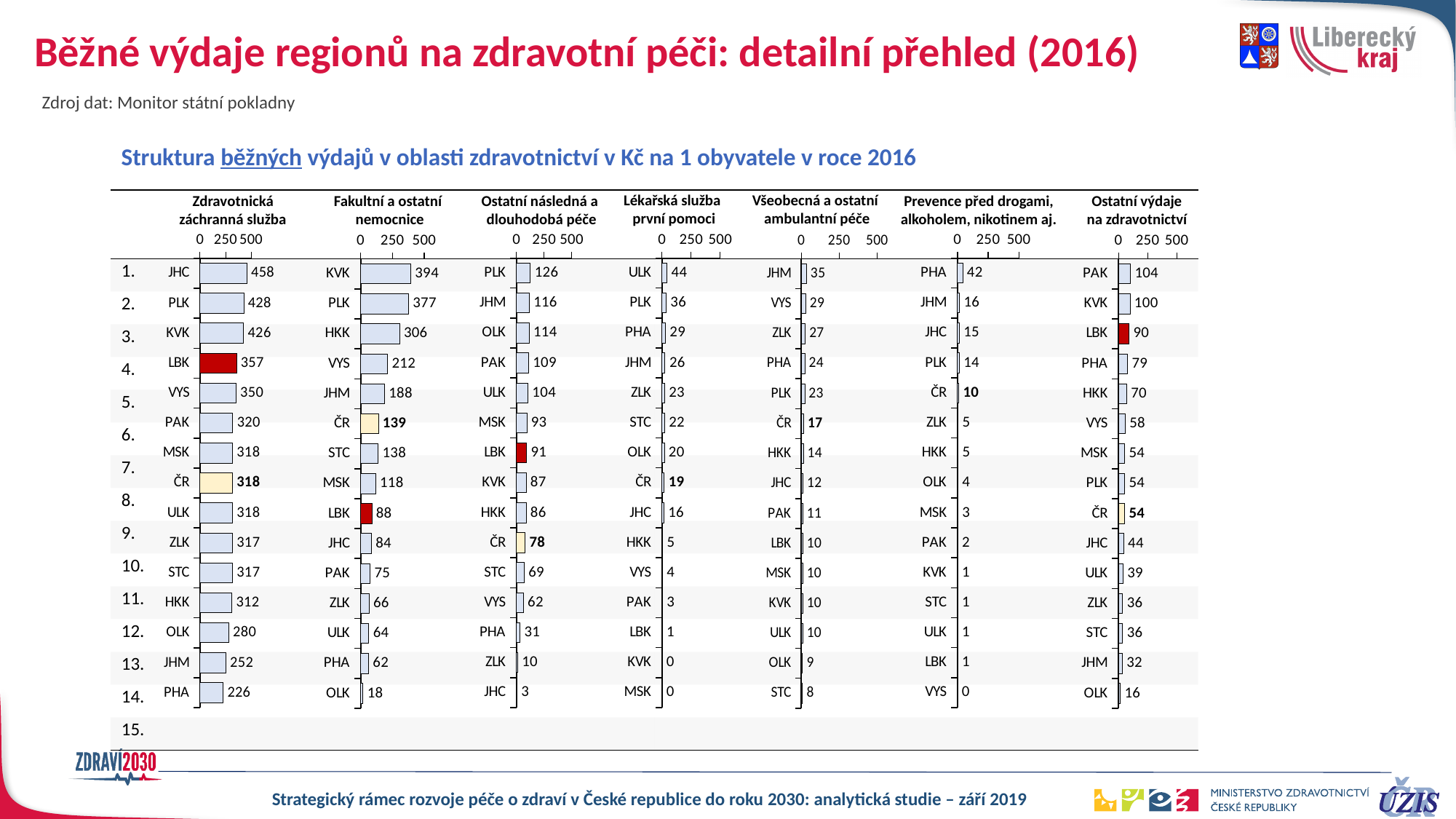
In the 'Ostatní výdaje na zdravotnictví' chart, what is the difference between the values for PAK and OLK? 88 In the 'Zdravotnická záchranná služba' chart, which region has the highest value? JHC In the 'Fakultní a ostatní nemocnice' chart, what is the difference between the values for KVK and LBK? 306 In the 'Ostatní následná a dlouhodobá péče' chart, what is the value for ČR? 78 In the 'Prevence před drogami, alkoholem, nikotinem aj.' chart, what is the value for PHA? 42 In the 'Zdravotnická záchranná služba' chart, what is the value for LBK? 357 In the 'Lékařská služba první pomoci' chart, which is larger, the value for ULK or the value for PLK? ULK In the 'Všeobecná a ostatní ambulantní péče' chart, what is the value for JHM? 35 How many bars are plotted in the 'Zdravotnická záchranná služba' chart? 15 What kind of chart is used for 'Ostatní výdaje na zdravotnictví'? Bar chart In the 'Fakultní a ostatní nemocnice' chart, what is the value for KVK? 394 In the 'Fakultní a ostatní nemocnice' chart, which region has the lowest value? OLK